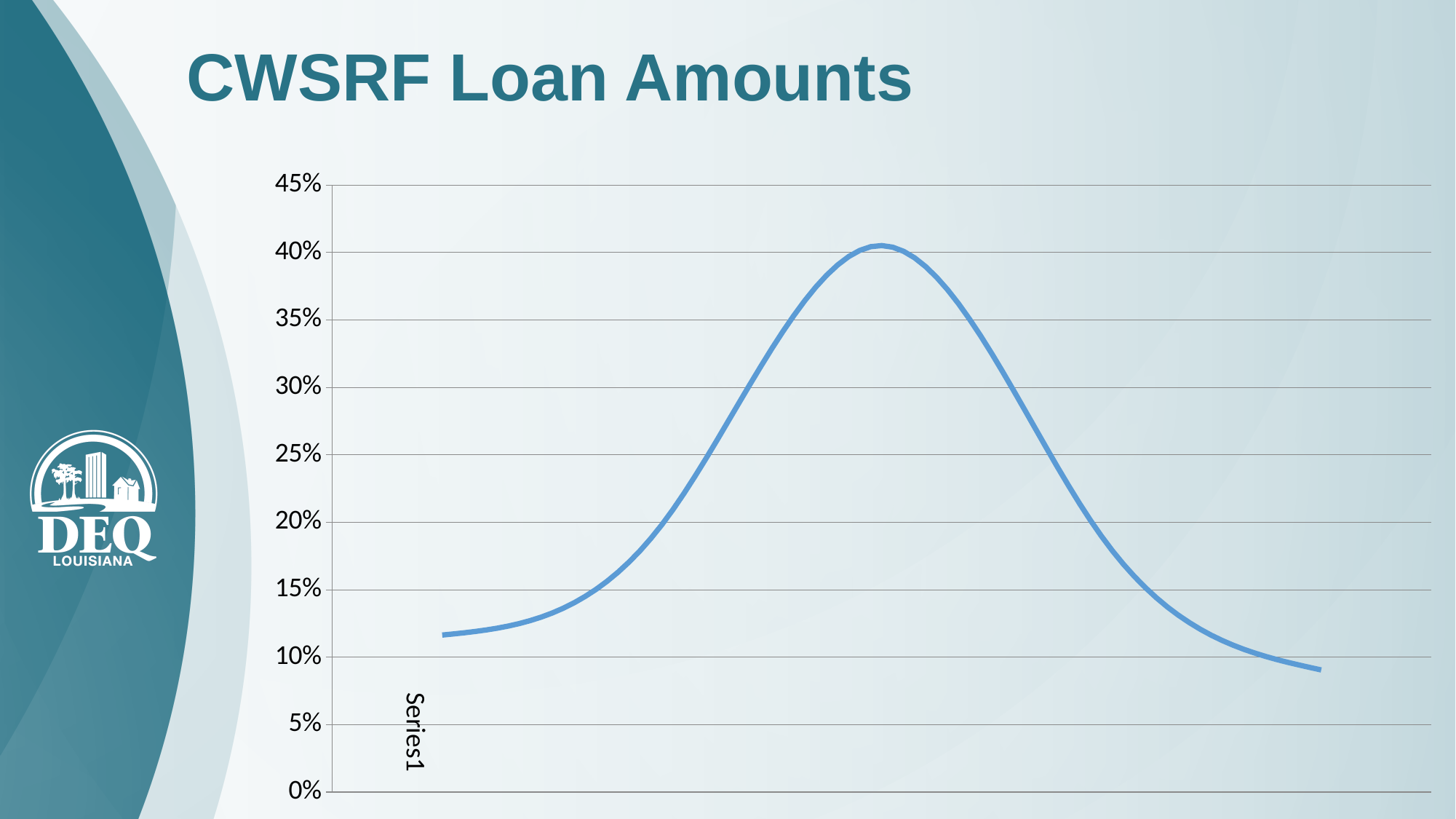
Which is larger, the value at the left end of the line or the value at the right end? the left end How does the line behave moving from left to right across the chart? rises to a peak, then falls What label appears on the horizontal axis of the chart? Series1 Is the value at the left end of the line greater or less than 15%? less What is the title of the chart? CWSRF Loan Amounts What is the highest value shown on the vertical axis? 45% Is the peak value of the line greater or less than 35%? greater Is the peak value of the line greater or less than 45%? less What type of chart is shown on the slide? line chart